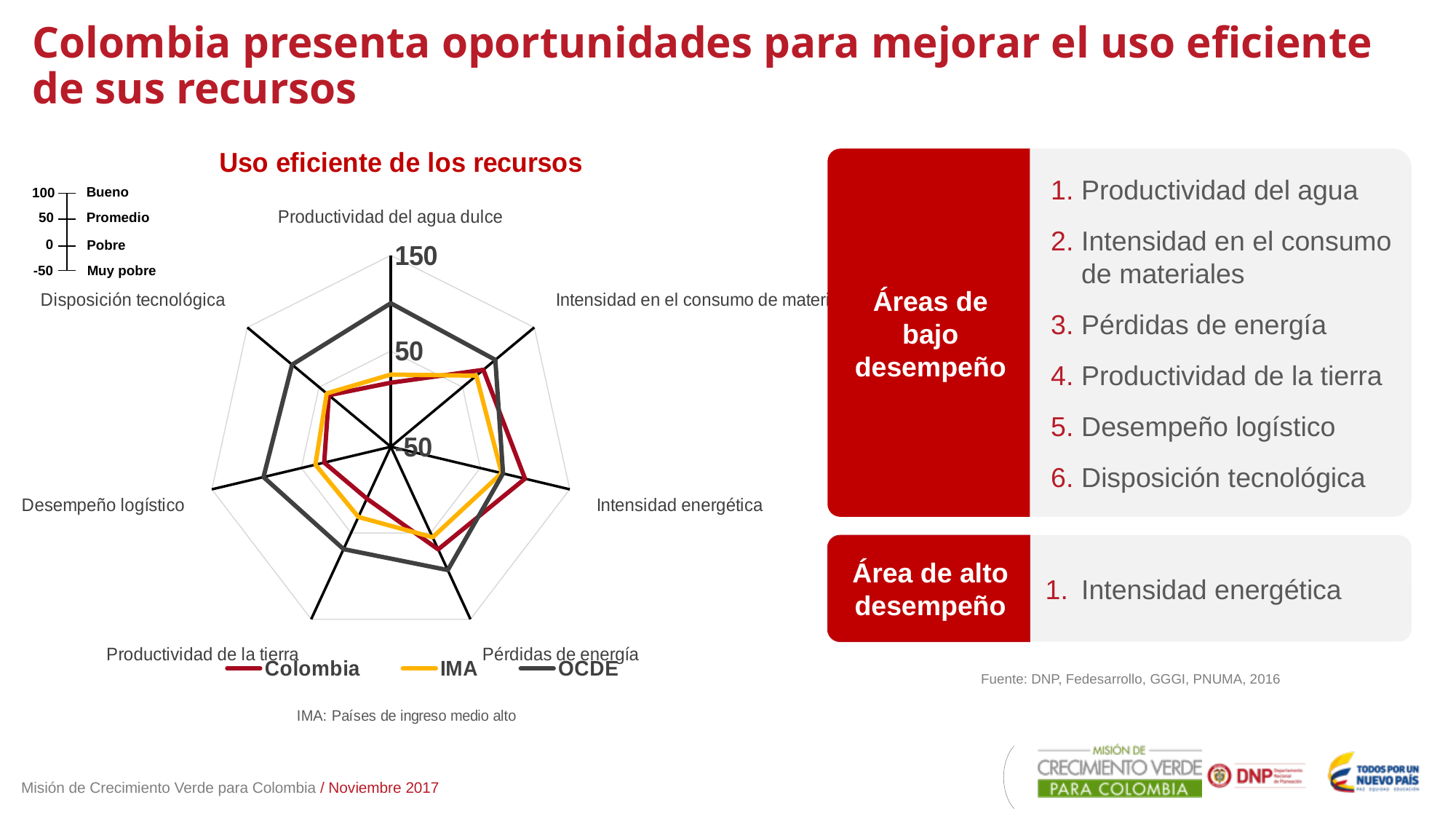
Which series are listed in the legend of the 'Uso eficiente de los recursos' chart? Colombia, IMA, OCDE In the 'Uso eficiente de los recursos' chart, on which axis does Colombia reach its highest value? Intensidad energética In the 'Uso eficiente de los recursos' chart, which is larger for Productividad del agua dulce: Colombia or OCDE? OCDE In the 'Uso eficiente de los recursos' chart, is the IMA value for Desempeño logístico greater or less than 50? less In the 'Uso eficiente de los recursos' chart, is the Colombia value for Intensidad energética greater or less than 50? greater How many series does the legend of the 'Uso eficiente de los recursos' chart list? 3 In the 'Uso eficiente de los recursos' chart, which is larger for Desempeño logístico: IMA or OCDE? OCDE How many categories (axes) does the 'Uso eficiente de los recursos' radar chart have? 7 In the 'Uso eficiente de los recursos' chart, is the OCDE value for Productividad del agua dulce greater or less than 50? greater What kind of chart is 'Uso eficiente de los recursos'? Radar chart What colour is the Colombia series in the 'Uso eficiente de los recursos' chart? Red